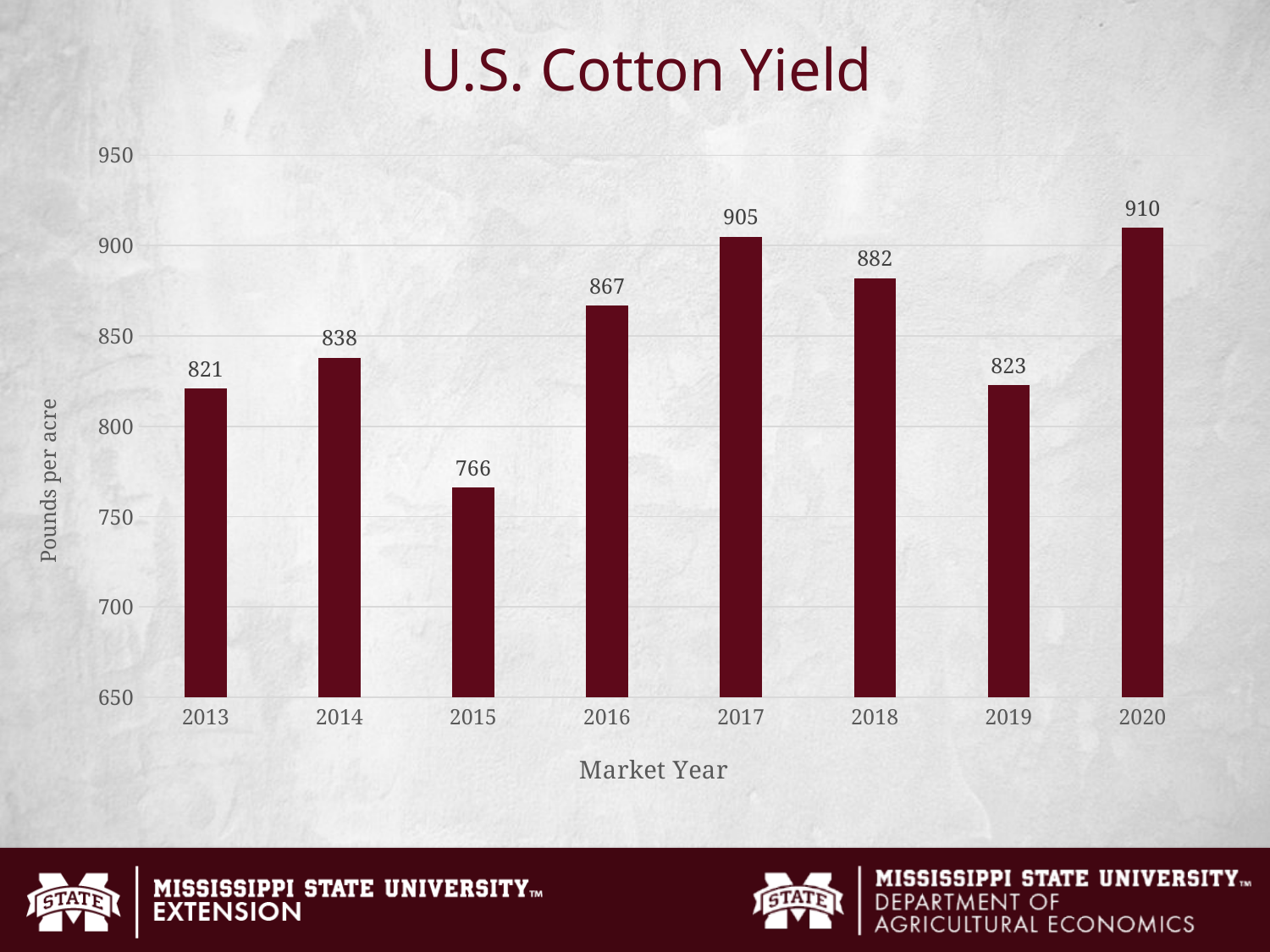
What is the difference in cotton yield between 2017 and 2016? 38 Is the cotton yield for 2017 greater or less than 900? greater What is the difference in cotton yield between 2020 and 2019? 87 How many market years are shown in the chart? 8 Which market year had the highest cotton yield? 2020 Did the cotton yield rise or fall from 2018 to 2019? Fall What was the U.S. cotton yield in 2018? 882 What was the U.S. cotton yield in 2015? 766 Which year had a higher cotton yield, 2014 or 2016? 2016 Which market year had the lowest cotton yield? 2015 What is the label on the vertical axis of the chart? Pounds per acre What kind of chart is shown on the slide? Bar chart